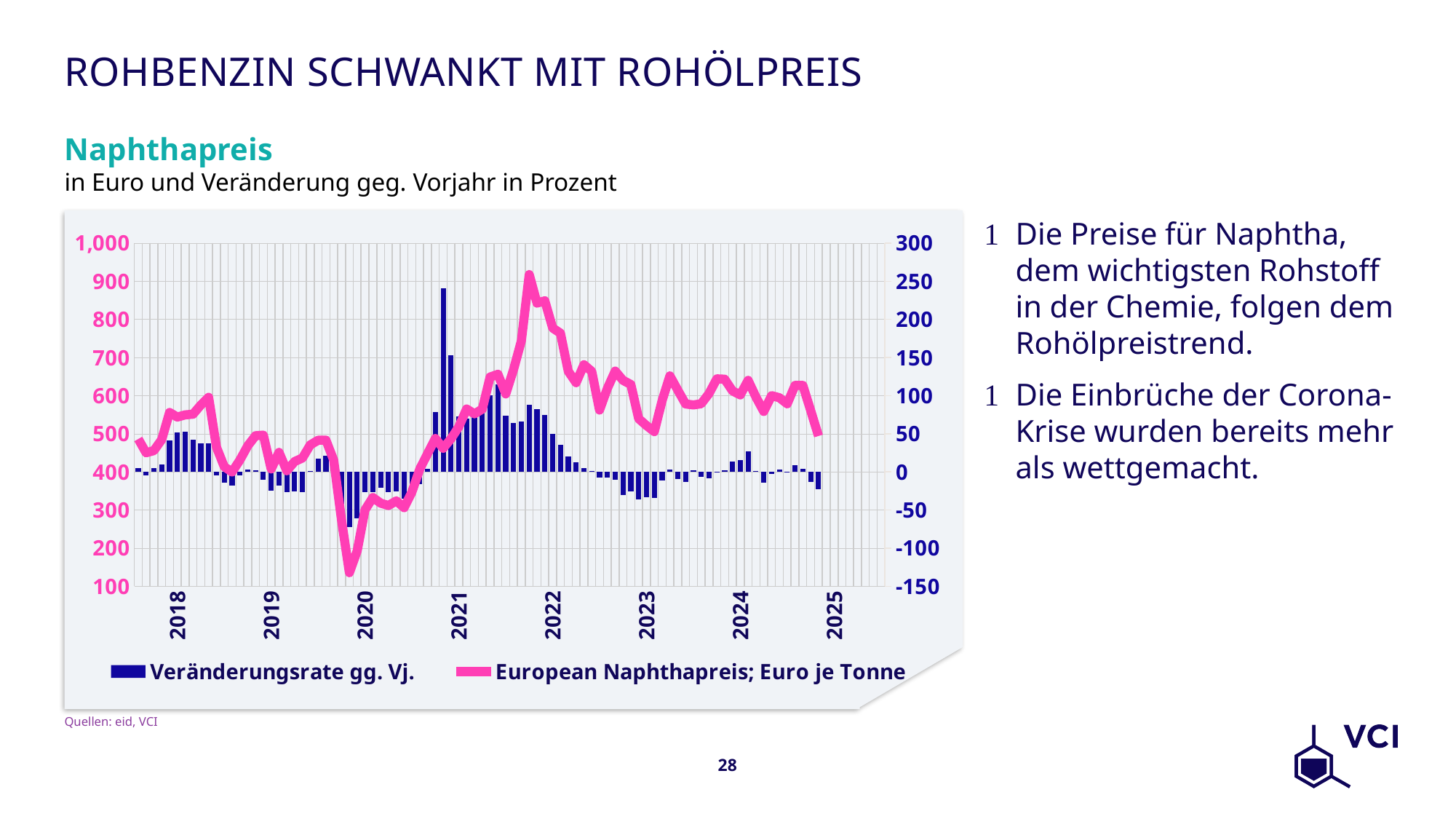
What is the title of the chart? Naphthapreis What kind of chart is shown on the slide? A combined bar and line chart In which year does the European naphtha price reach its lowest point? 2020 Is the lowest bar for Veränderungsrate gg. Vj. (in 2020) greater or less than -50? less Is the highest bar for Veränderungsrate gg. Vj. (around the start of 2021) greater or less than 200? greater Is the European naphtha price at its lowest point in 2020 greater or less than 200? less Which series is drawn as a pink line? European Naphthapreis; Euro je Tonne In which year does the European naphtha price reach its highest point? 2022 How many series does the chart legend list? 2 Does the European naphtha price rise or fall from its 2022 peak to 2025? fall Is the European naphtha price higher at the start of 2022 or at the start of 2020? Start of 2022